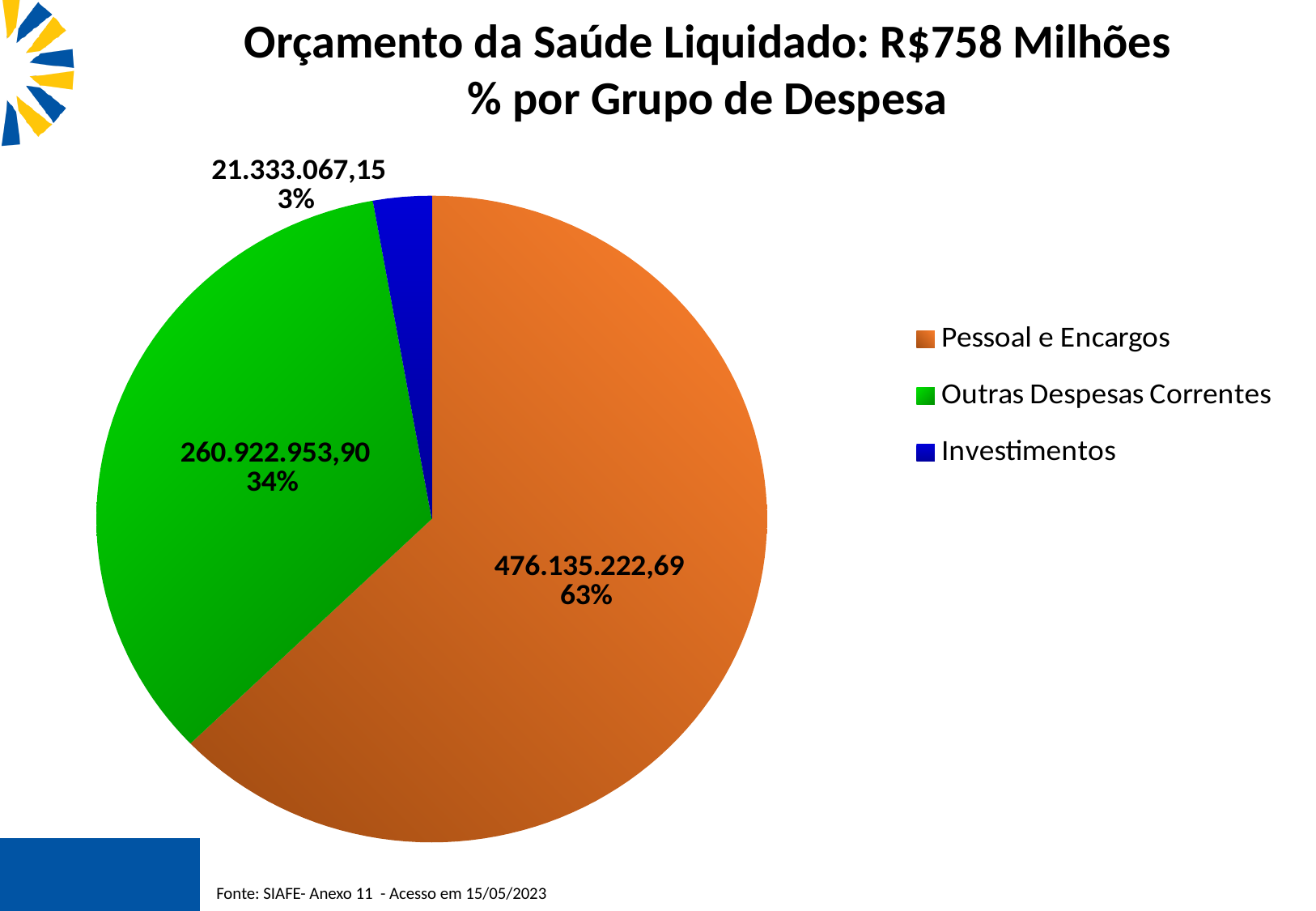
Which is larger, Outras Despesas Correntes or Investimentos? Outras Despesas Correntes What share of the pie does Outras Despesas Correntes represent? 34% Which expense group has the smallest slice? Investimentos What share of the pie does Pessoal e Encargos represent? 63% What share of the pie does Investimentos represent? 3% What is the value for Outras Despesas Correntes? 260.922.953,90 Which expense group has the largest slice? Pessoal e Encargos What type of chart is shown on the slide? Pie chart What is the title of the chart? Orçamento da Saúde Liquidado: R$758 Milhões % por Grupo de Despesa How many expense groups are shown in the pie chart? 3 What is the value for Investimentos? 21.333.067,15 What is the value for Pessoal e Encargos? 476.135.222,69